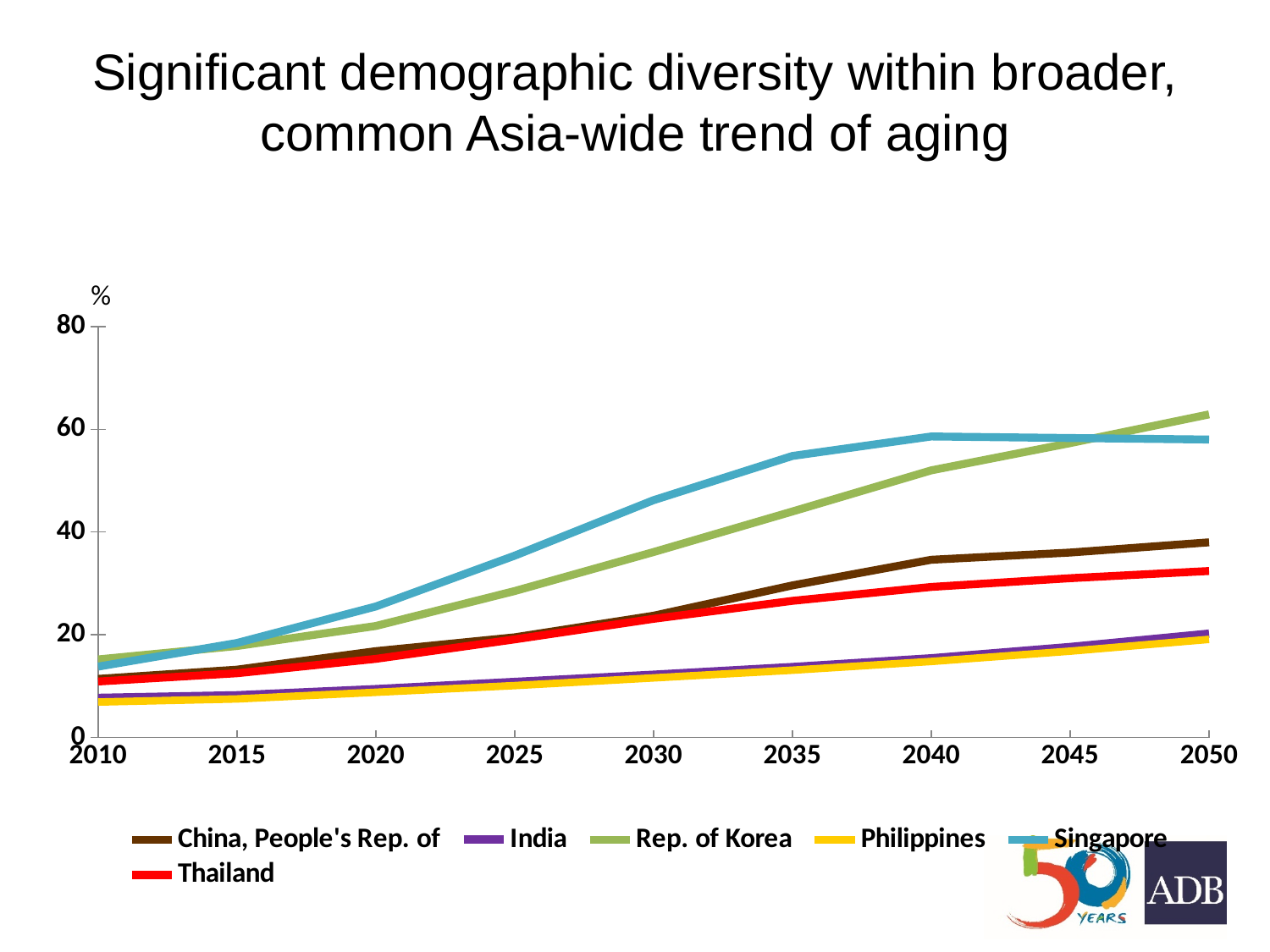
What unit is shown at the top of the y axis? % Which country has the highest value in 2035? Singapore Which is larger in 2050, the value for China, People's Rep. of or the value for Thailand? China, People's Rep. of Is the value for Philippines in 2050 greater or less than 40? less Is the value for India in 2030 greater or less than 20? less How many year labels are shown along the x axis? 9 Do the values for Rep. of Korea rise or fall from 2010 to 2050? rise Which is larger in 2030, the value for Singapore or the value for Thailand? Singapore What kind of chart is shown on the slide? line chart How many series does the legend list? 6 Which country has the highest value in 2050? Rep. of Korea Is the value for Singapore in 2040 greater or less than 40? greater